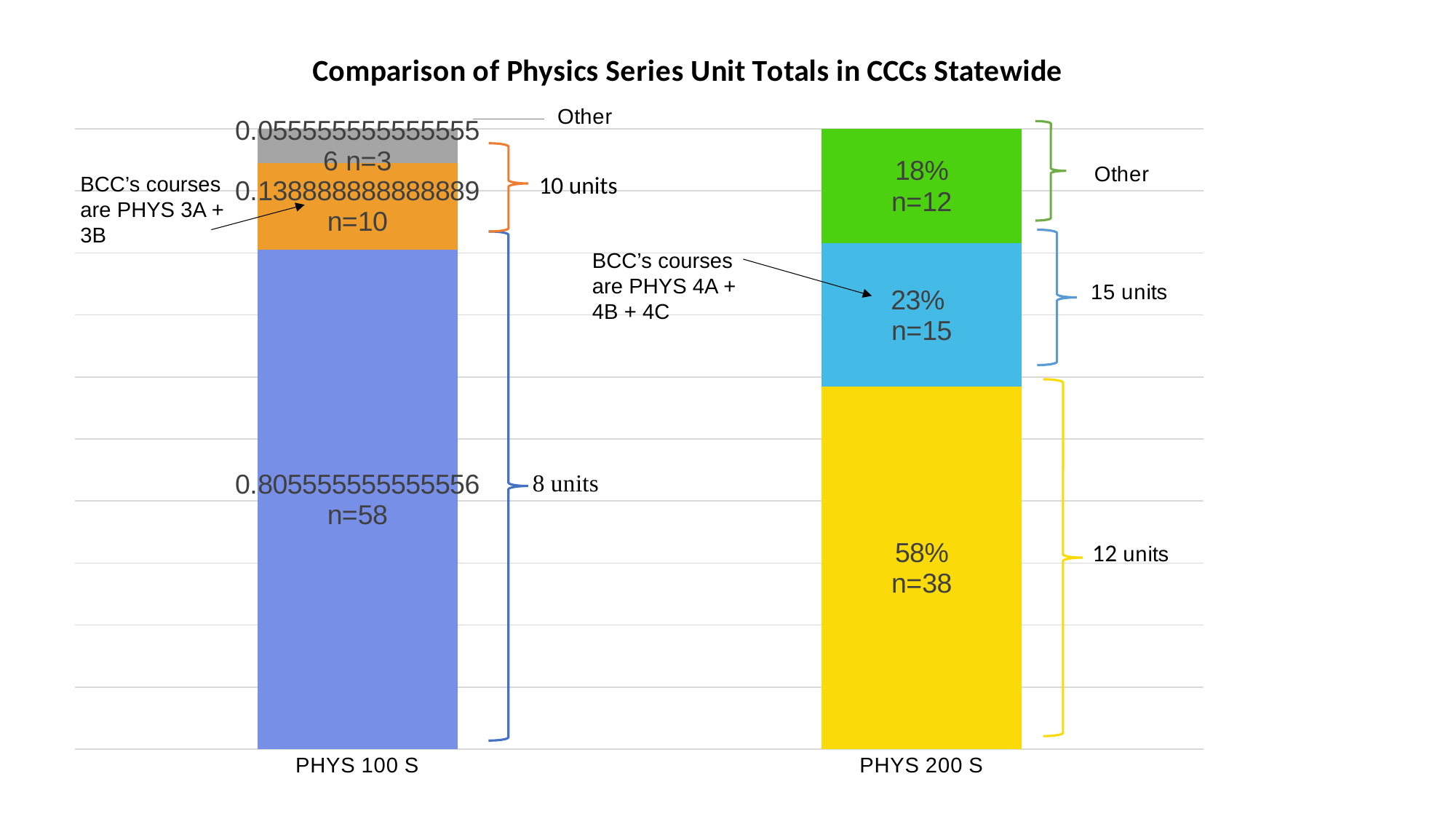
What percentage is shown for the Other segment of the PHYS 200 S bar? 18% What is the n value for the 8 units segment of the PHYS 100 S bar? n=58 What is the n value for the 15 units segment of the PHYS 200 S bar? n=15 What kind of chart is shown on the slide? Stacked bar chart How many categories are shown on the x axis of the chart? 2 What is the difference in percentage points between the 12 units segment and the 15 units segment of the PHYS 200 S bar? 35 percentage points Which segment of the PHYS 200 S bar is the smallest? Other (18%) What is the chart's title? Comparison of Physics Series Unit Totals in CCCs Statewide What percentage is shown for the 12 units segment of the PHYS 200 S bar? 58% What is the n value for the 10 units segment of the PHYS 100 S bar? n=10 Which segment of the PHYS 200 S bar is the largest? 12 units (58%) What is the total n across all three segments of the PHYS 200 S bar? 65